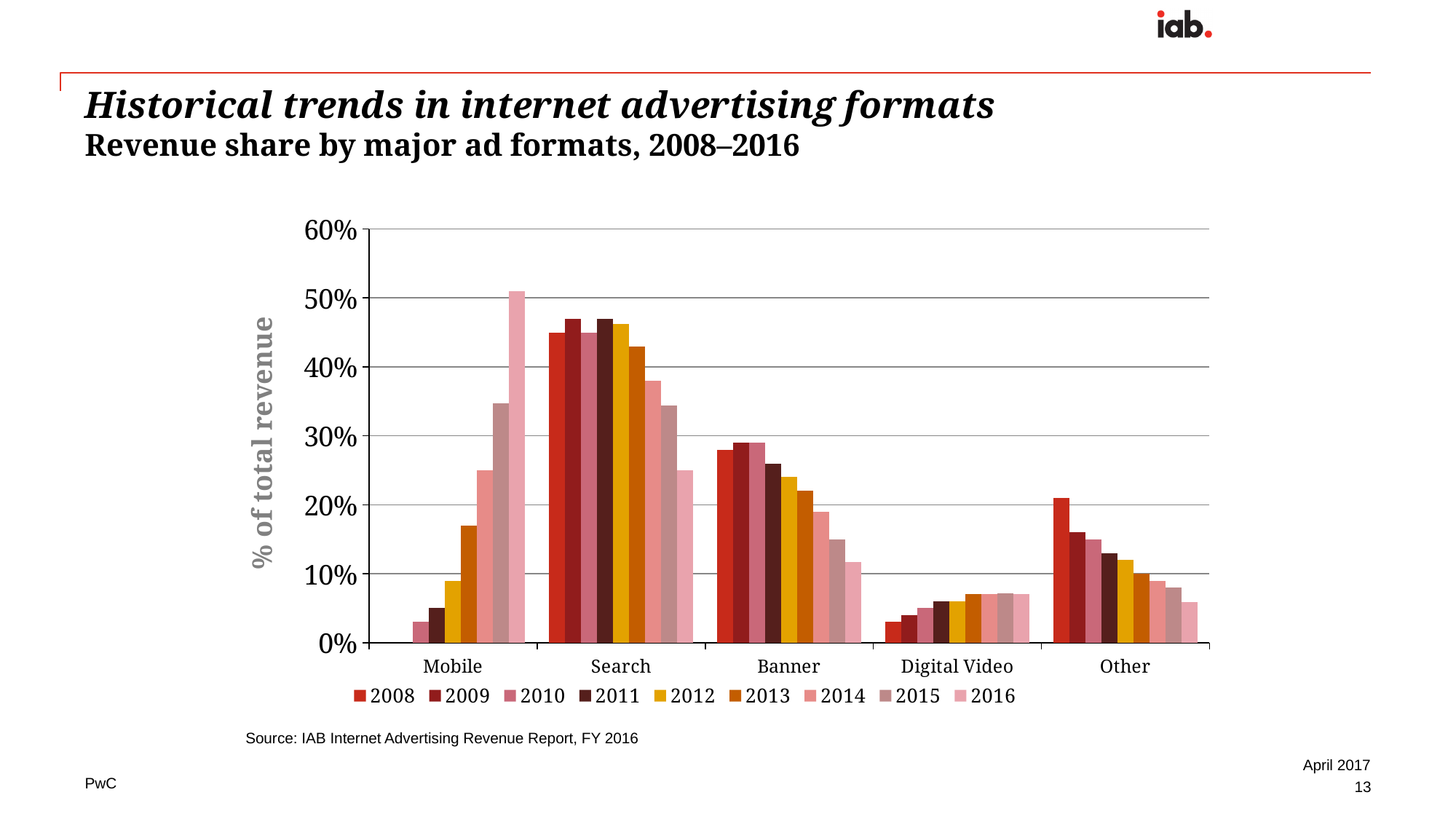
Do the Search values rise or fall from 2012 to 2016? fall Is the 2016 value for Search greater or less than 30%? less How many ad format categories are shown on the x axis? 5 What kind of chart is shown on the slide? Bar chart Do the Mobile values rise or fall from 2010 to 2016? rise Is the 2016 value for Mobile greater or less than 40%? greater Is the 2016 value for Banner greater or less than 20%? less Which ad format has the highest 2016 value? Mobile Which is larger in 2008, the value for Banner or the value for Other? Banner How many series (years) does the legend list? 9 Do the Other values rise or fall from 2008 to 2016? fall Which ad format has the highest 2008 value? Search